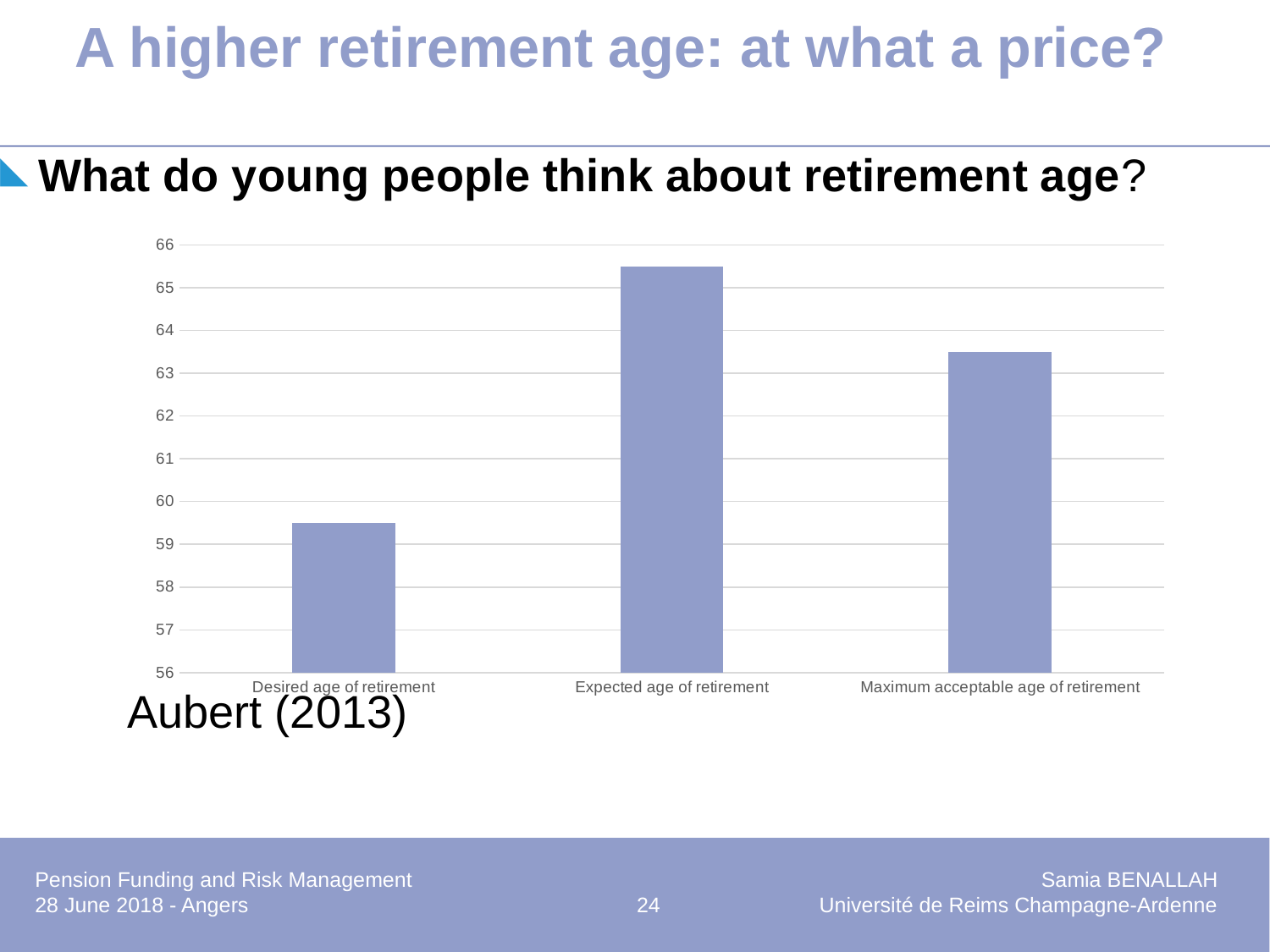
How many categories are plotted in the chart? 3 Is the value for Desired age of retirement greater or less than 59? greater Is the value for Maximum acceptable age of retirement greater or less than 64? less Which is larger: the value for Expected age of retirement or the value for Maximum acceptable age of retirement? Expected age of retirement Which category has the lowest value? Desired age of retirement What kind of chart is shown on the slide? bar chart Is the value for Maximum acceptable age of retirement greater or less than 63? greater Which is larger: the value for Desired age of retirement or the value for Maximum acceptable age of retirement? Maximum acceptable age of retirement Which category has the highest value? Expected age of retirement What is the lowest value shown on the vertical axis of the chart? 56